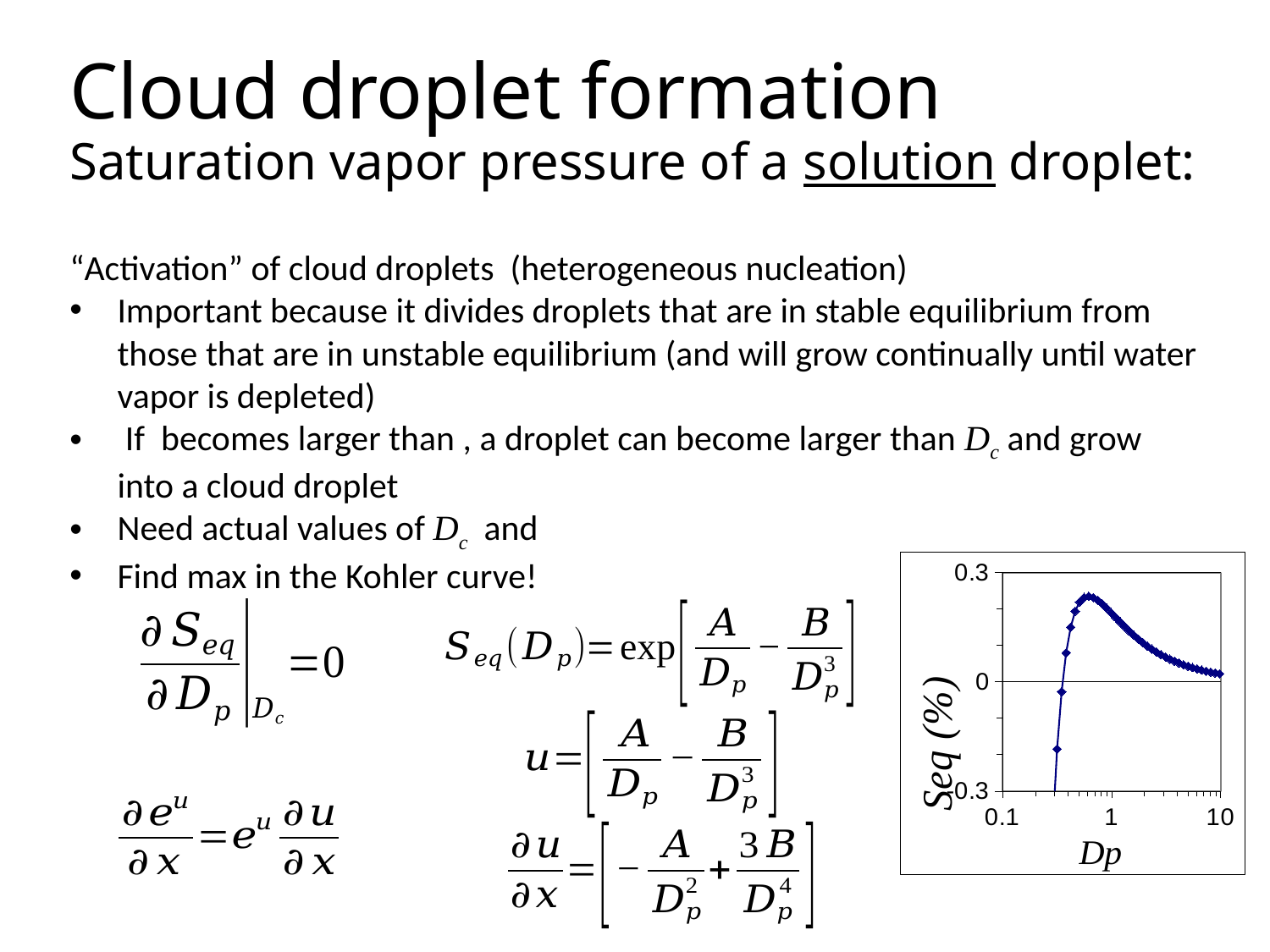
Is the peak value of the curve greater or less than 0? greater Is the value of Seq (%) at the smallest plotted Dp greater or less than 0? less What is the label of the y axis of the chart? Seq (%) Is the value of Seq (%) at Dp = 1 greater or less than 0? greater What kind of chart is shown on the slide? line chart What is the highest tick value shown on the y axis of the chart? 0.3 What is the lowest tick value shown on the y axis of the chart? -0.3 After reaching its peak, does the curve rise or fall as Dp increases toward 10? fall Does the curve rise or fall as Dp increases from its smallest plotted value up to the peak? rise